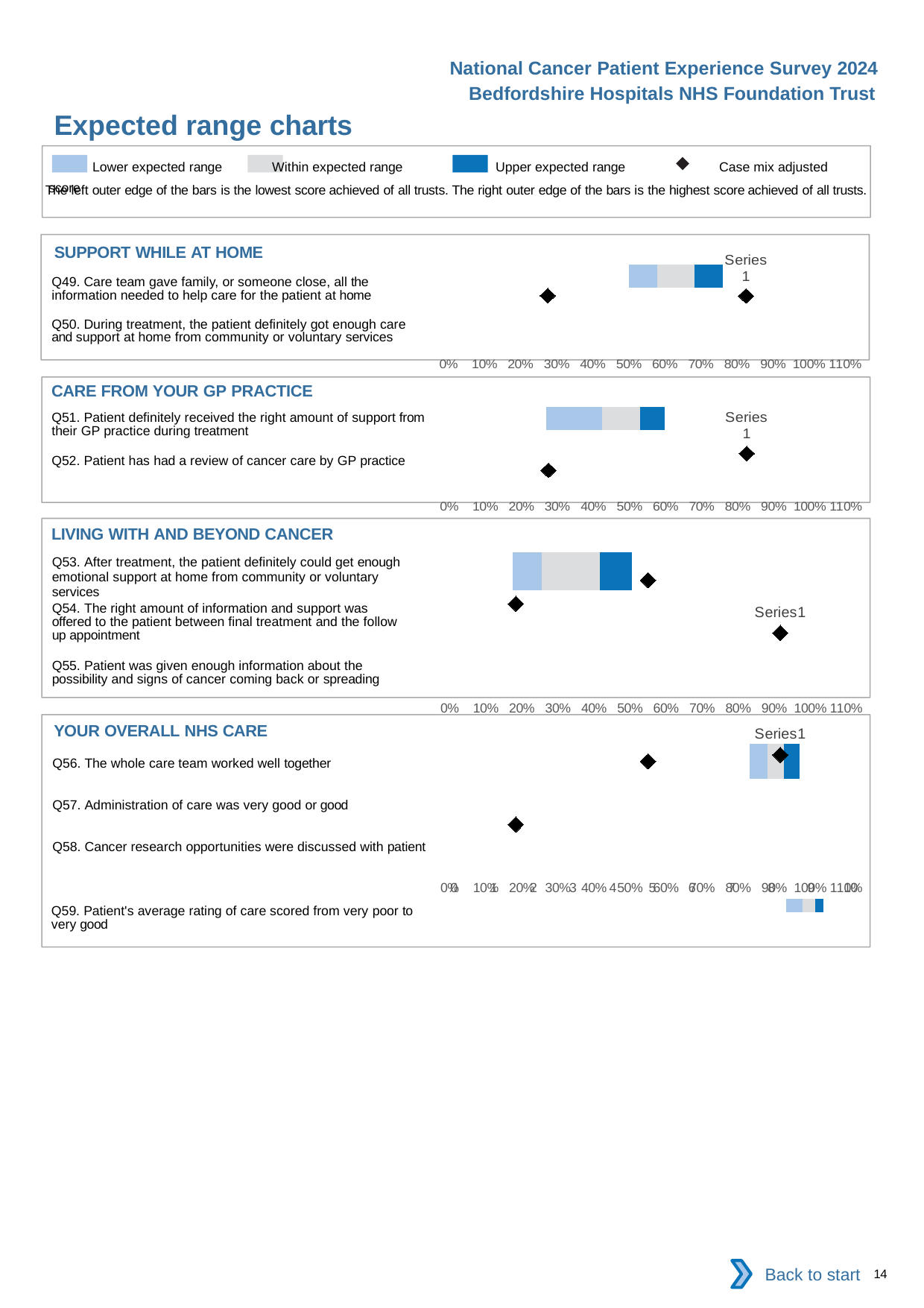
In the 'SUPPORT WHILE AT HOME' chart, is the 'Series 1' diamond marker greater or less than 70%? greater In the 'CARE FROM YOUR GP PRACTICE' chart, is the 'Series 1' diamond marker greater or less than 70%? greater How many questions are listed in the 'LIVING WITH AND BEYOND CANCER' chart? 3 What is the highest tick label shown on the x axis of the 'CARE FROM YOUR GP PRACTICE' chart? 110% In the 'YOUR OVERALL NHS CARE' chart, is the 'Series1' diamond marker greater or less than 80%? greater How many questions are listed in the 'SUPPORT WHILE AT HOME' chart? 2 How many questions are listed in the 'CARE FROM YOUR GP PRACTICE' chart? 2 What kind of chart is used in the 'SUPPORT WHILE AT HOME' section? bar chart How many entries does the legend at the top of the slide list? 4 According to the legend, what does the diamond marker represent? Case mix adjusted score